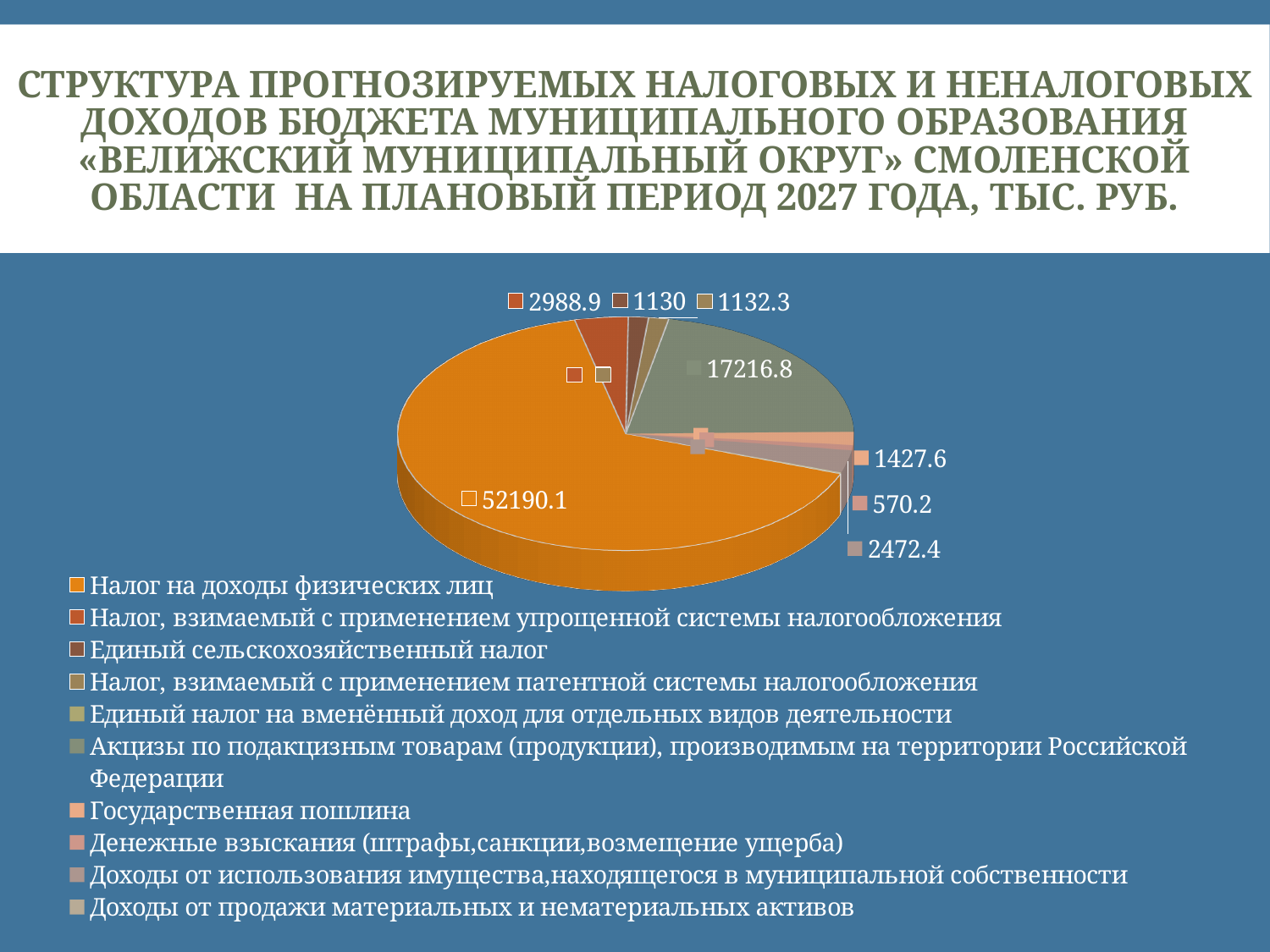
How many categories does the legend of the pie chart list? 10 What is the difference between the two largest labelled values, 52190.1 and 17216.8? 34973.3 What is the value shown for Налог на доходы физических лиц? 52190.1 What is the value of the largest slice of the pie chart? 52190.1 What is the value shown for Акцизы по подакцизным товарам (продукции), производимым на территории Российской Федерации? 17216.8 Which is larger: the slice labelled 2988.9 or the slice labelled 2472.4? 2988.9 What is the smallest value printed as a data label on the pie chart? 570.2 What is the value shown for Налог, взимаемый с применением упрощенной системы налогообложения? 2988.9 What kind of chart is shown on the slide? pie chart Which category has the largest slice of the pie chart? Налог на доходы физических лиц For which planning year does the chart title say the revenue structure is forecast? 2027 What is the difference between the slices labelled 1132.3 and 1130? 2.3